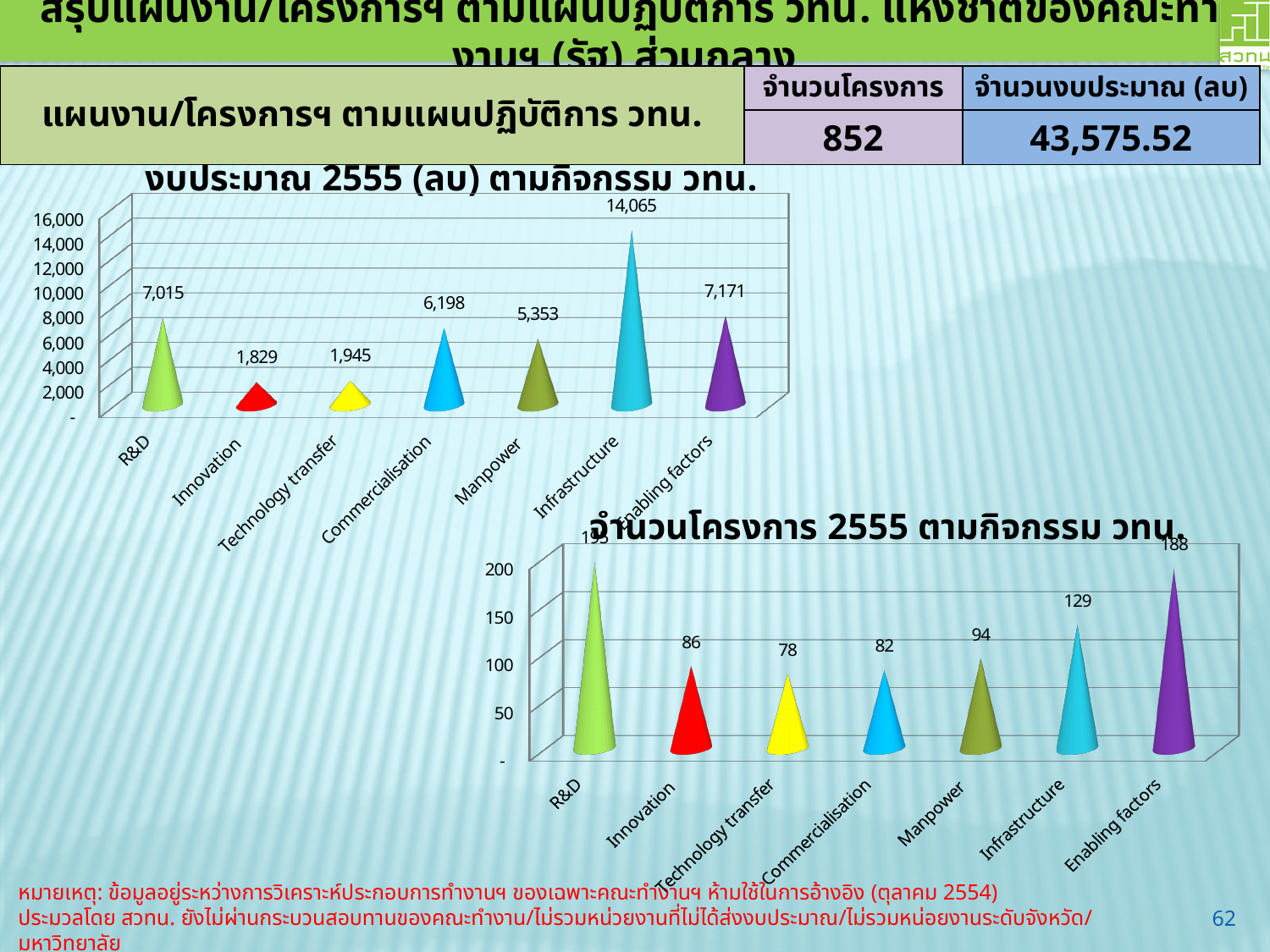
In the bottom chart (จำนวนโครงการ 2555 ตามกิจกรรม วทน.), which category has the lowest value? Technology transfer In the top chart (งบประมาณ 2555 (ลบ) ตามกิจกรรม วทน.), which is larger, Commercialisation or Manpower? Commercialisation In the top chart (งบประมาณ 2555 (ลบ) ตามกิจกรรม วทน.), which category has the lowest value? Innovation In the bottom chart (จำนวนโครงการ 2555 ตามกิจกรรม วทน.), what is the value for Manpower? 94 In the top chart (งบประมาณ 2555 (ลบ) ตามกิจกรรม วทน.), which category has the highest value? Infrastructure What kind of chart is the bottom chart (จำนวนโครงการ 2555 ตามกิจกรรม วทน.)? Bar chart In the bottom chart (จำนวนโครงการ 2555 ตามกิจกรรม วทน.), what is the value for Infrastructure? 129 In the top chart (งบประมาณ 2555 (ลบ) ตามกิจกรรม วทน.), what is the difference between Enabling factors and R&D? 156 In the bottom chart (จำนวนโครงการ 2555 ตามกิจกรรม วทน.), what is the difference between Enabling factors and Infrastructure? 59 In the top chart (งบประมาณ 2555 (ลบ) ตามกิจกรรม วทน.), what is the value for Infrastructure? 14,065 In the top chart (งบประมาณ 2555 (ลบ) ตามกิจกรรม วทน.), what is the value for Innovation? 1,829 How many categories are shown in the top chart (งบประมาณ 2555 (ลบ) ตามกิจกรรม วทน.)? 7